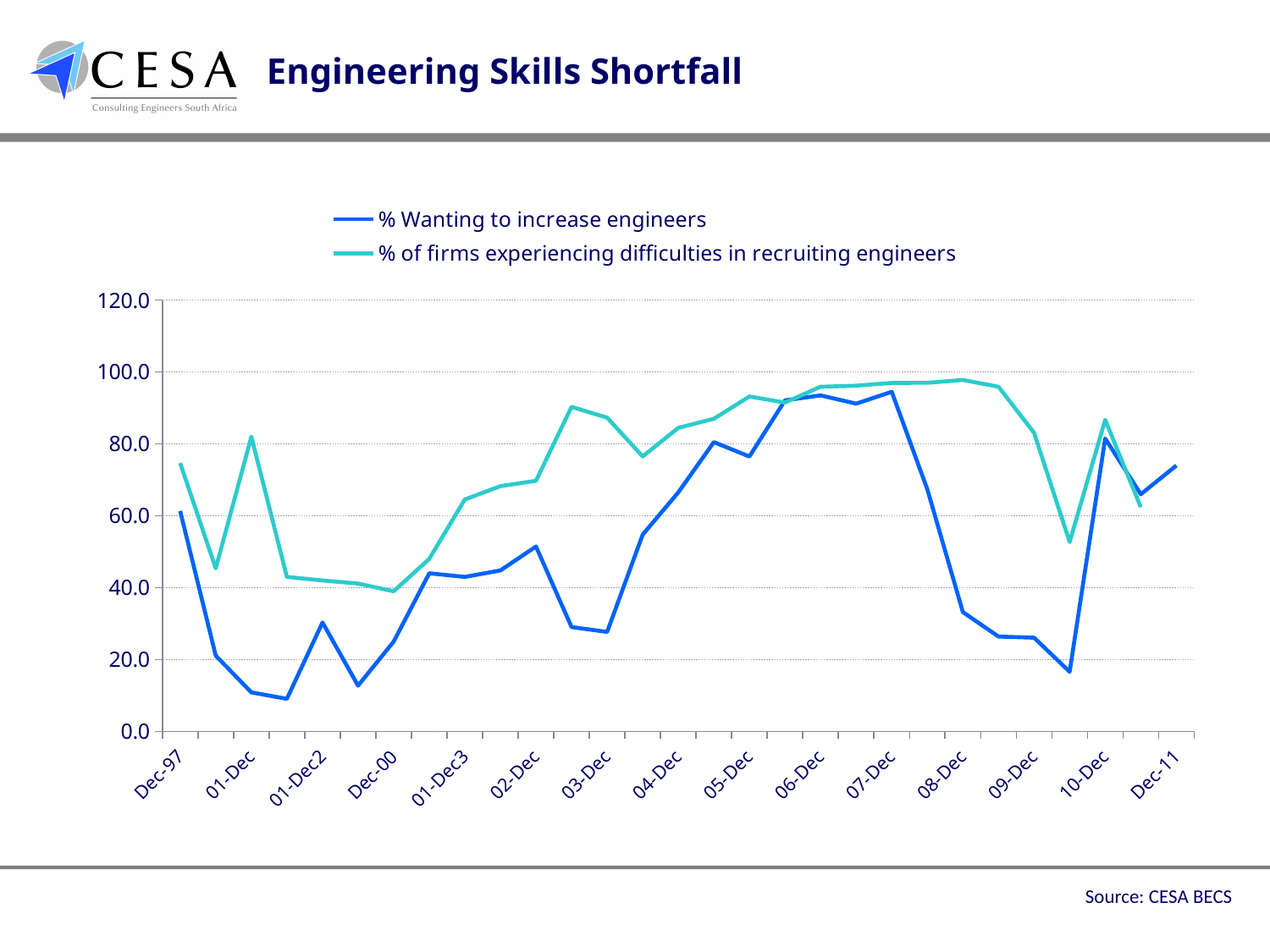
Is the value for '% Wanting to increase engineers' at 01-Dec greater or less than 20? less Is the value for '% of firms experiencing difficulties in recruiting engineers' at 08-Dec greater or less than 80? greater Is the value for '% Wanting to increase engineers' at 09-Dec greater or less than 40? less Does the '% Wanting to increase engineers' line rise or fall between 07-Dec and 09-Dec? fall At 03-Dec, which series has the higher value: '% Wanting to increase engineers' or '% of firms experiencing difficulties in recruiting engineers'? % of firms experiencing difficulties in recruiting engineers What source is cited for the chart? CESA BECS How many labelled points are there along the x axis? 15 What kind of chart is shown on the slide? line chart How many series does the legend list? 2